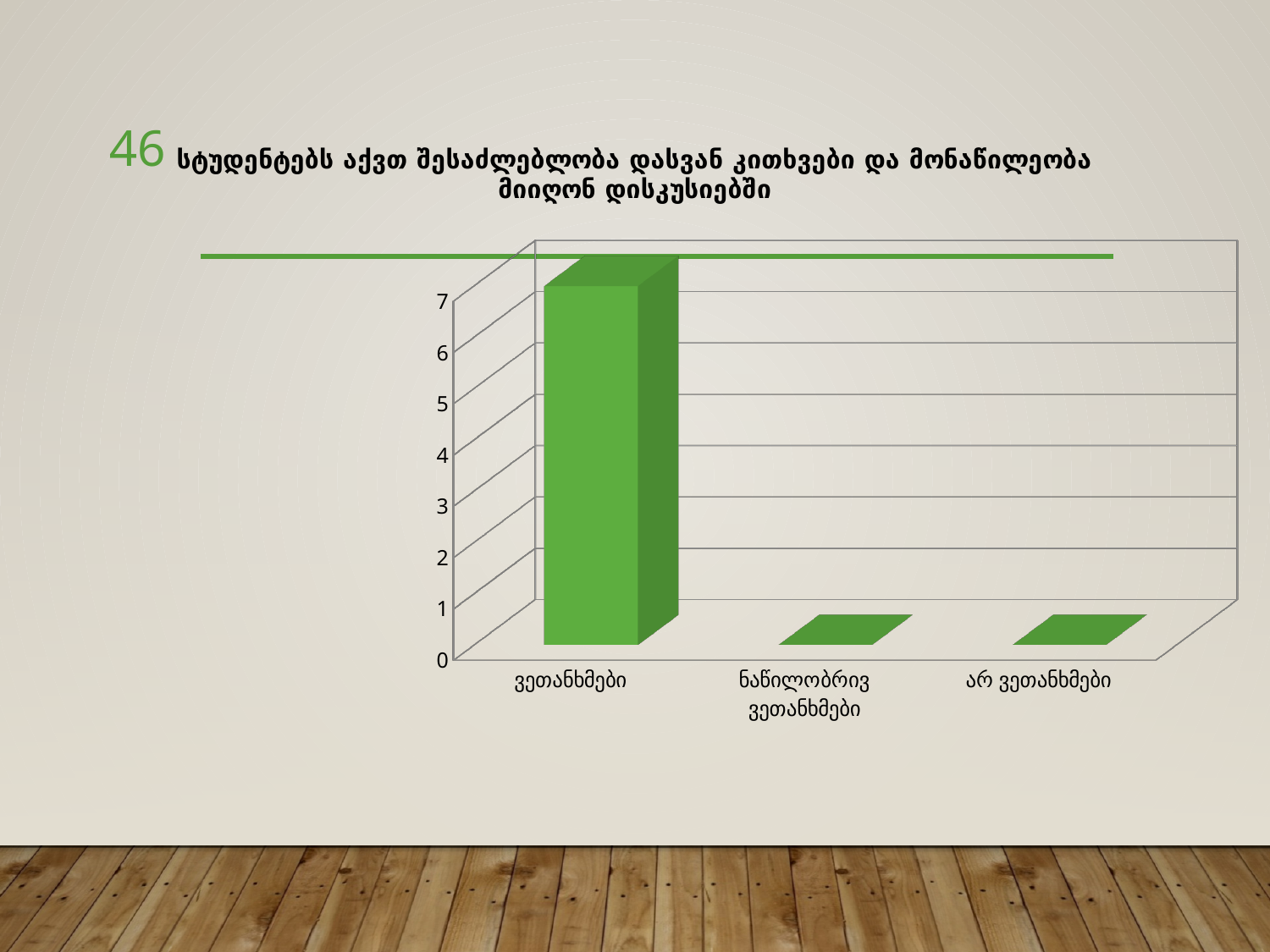
Which category has the highest value in the chart? ვეთანხმები How many categories are shown on the x axis of the chart? 3 Is the value for ვეთანხმები greater or less than 6? greater What colour are the bars in the chart? green What is the value for არ ვეთანხმები? 0 How many categories in the chart have a value of 0? 2 What kind of chart is shown on the slide? bar chart Is the value for ნაწილობრივ ვეთანხმები greater or less than 1? less Which is larger, the value for ვეთანხმები or the value for არ ვეთანხმები? ვეთანხმები What is the value for ნაწილობრივ ვეთანხმები? 0 What is the highest tick value shown on the vertical axis? 7 Is the value for ვეთანხმები greater or less than 3? greater